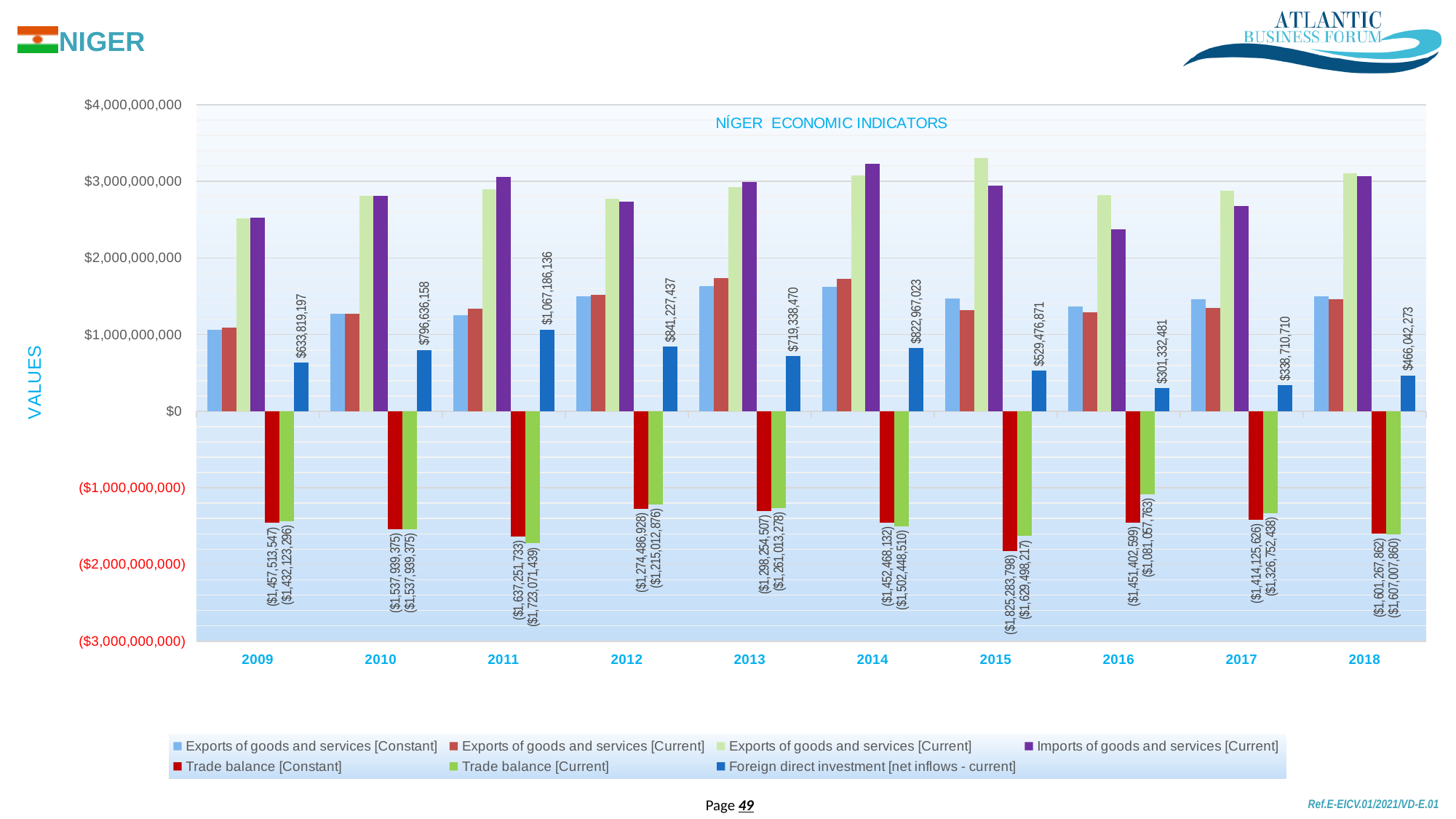
What is the value of Foreign direct investment [net inflows - current] in 2011? $1,067,186,136 In which year is Foreign direct investment [net inflows - current] highest? 2011 In which year is Foreign direct investment [net inflows - current] lowest? 2016 What kind of chart is this? Bar chart How many series does the legend list? 7 What is the difference between Foreign direct investment in 2011 and in 2016? $765,853,655 What is the title of the chart? NÍGER ECONOMIC INDICATORS Is the value for Imports of goods and services [Current] in 2016 greater or less than $2,000,000,000? greater Does Foreign direct investment [net inflows - current] rise or fall from 2014 to 2016? Fall Which is larger, Foreign direct investment in 2012 or in 2013? 2012 How many years are shown on the x axis? 10 What is the value of Trade balance [Current] in 2016? ($1,081,057,763)